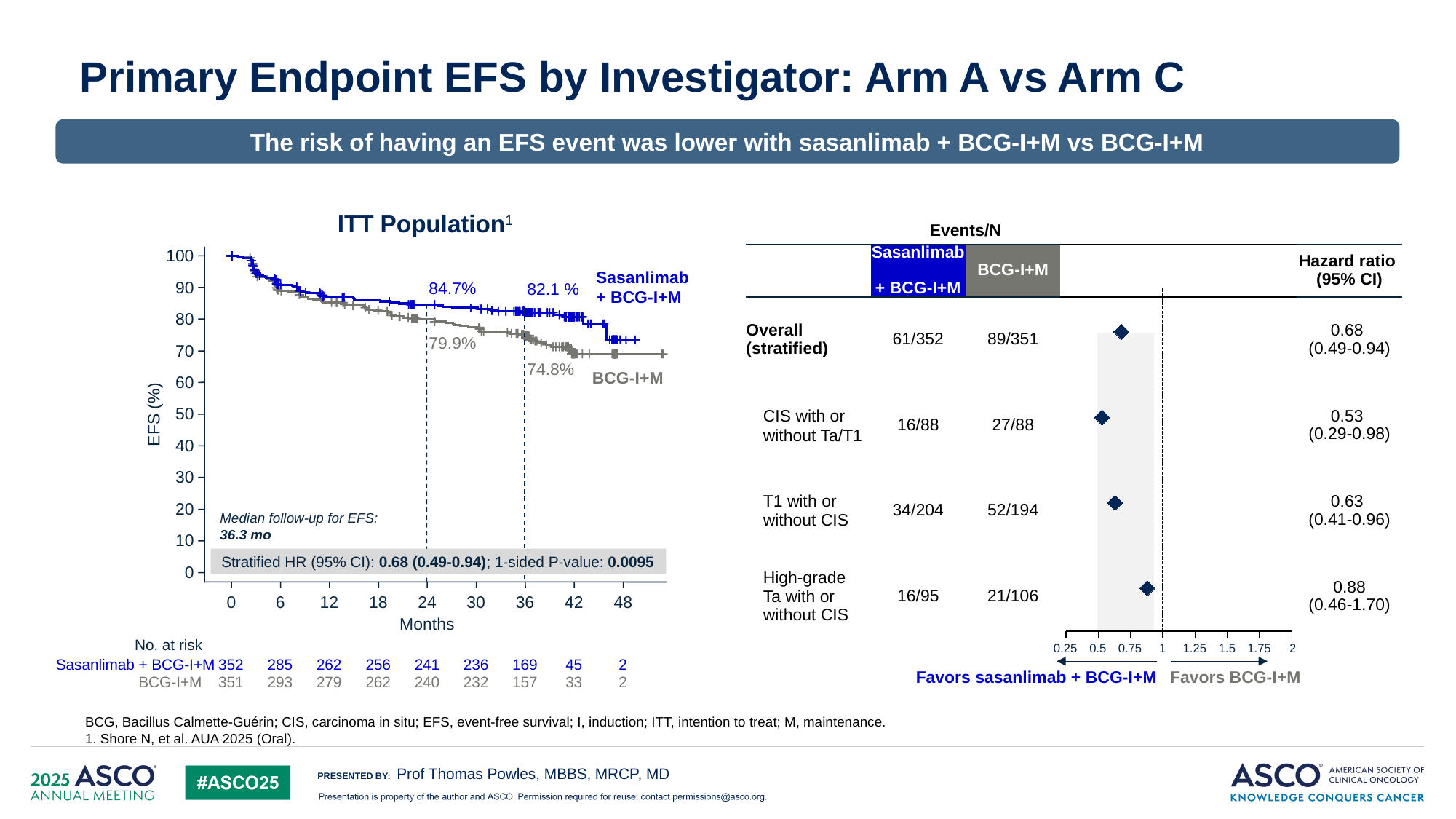
In the ITT Population chart, how many patients were at risk in the BCG-I+M arm at 12 months? 279 In the forest plot on the right, how many events/N are reported for BCG-I+M in the T1 with or without CIS subgroup? 52/194 In the forest plot on the right, what is the hazard ratio (95% CI) for the CIS with or without Ta/T1 subgroup? 0.53 (0.29-0.98) In the ITT Population chart, what is the stratified HR (95% CI) shown? 0.68 (0.49-0.94) In the ITT Population chart, do the EFS curves rise or fall as months increase? fall In the ITT Population chart, how many series (arms) are plotted? 2 In the ITT Population chart, what is the EFS rate for BCG-I+M at 36 months? 74.8% In the ITT Population chart, what is the difference between the 24-month EFS rates of Sasanlimab + BCG-I+M and BCG-I+M? 4.8% In the ITT Population chart, which arm has the higher EFS rate at 36 months? Sasanlimab + BCG-I+M In the forest plot on the right, how many rows (subgroups including Overall) are plotted? 4 In the forest plot on the right, which subgroup has the highest hazard ratio? High-grade Ta with or without CIS In the ITT Population chart, what is the EFS rate for Sasanlimab + BCG-I+M at 24 months? 84.7%